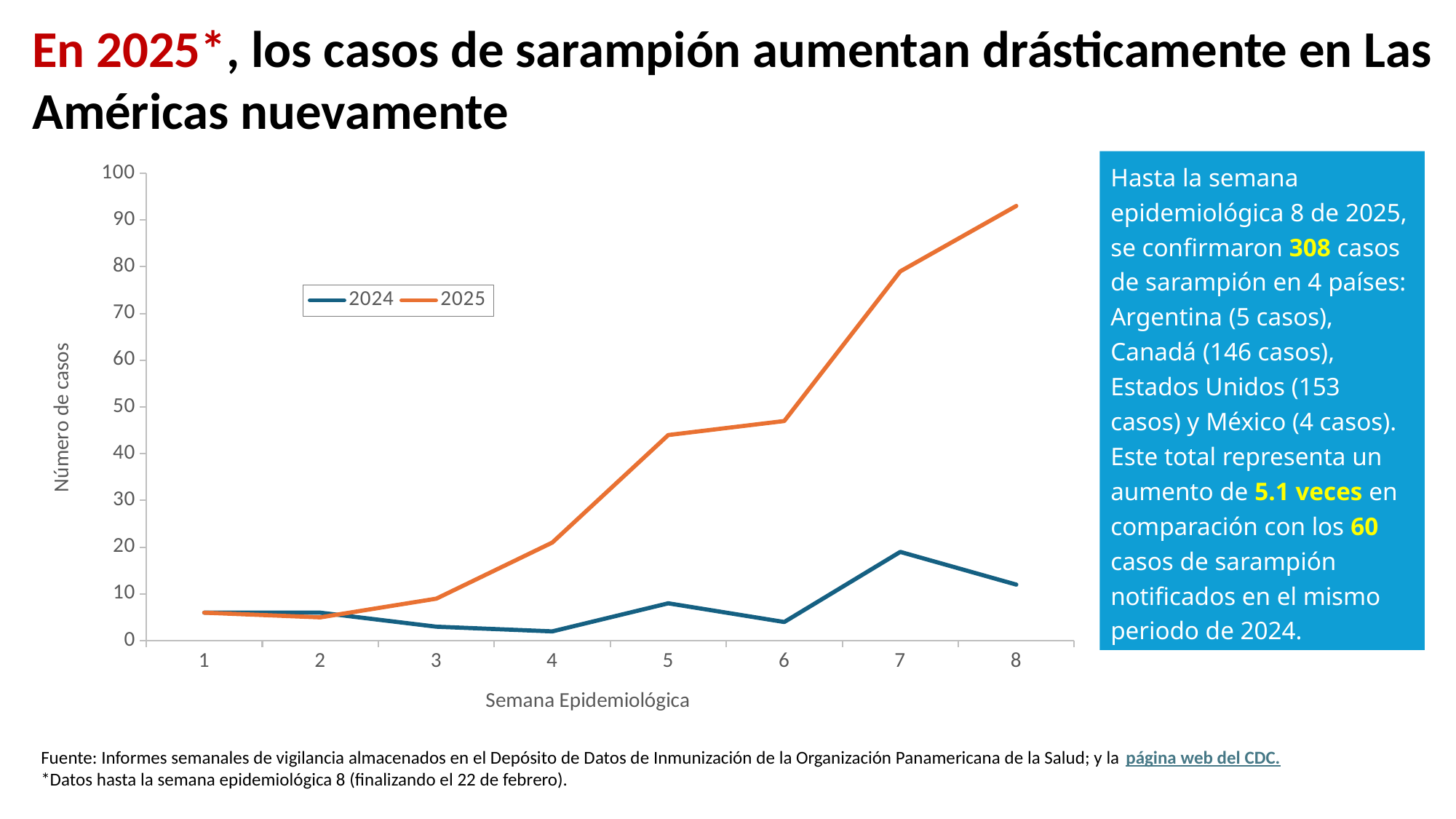
What kind of chart is shown on the slide? line chart How many series does the chart legend list? 2 Is the value for 2025 in week 7 greater or less than 70? greater What is the title of the y axis? Número de casos Is the value for 2025 in week 4 greater or less than 30? less In week 8, which series has the larger value, 2024 or 2025? 2025 How many epidemiological weeks are plotted along the x axis? 8 Is the value for 2024 in week 7 greater or less than 30? less In which epidemiological week does the 2024 series reach its highest value? 7 In which epidemiological week does the 2025 series reach its highest value? 8 Does the 2025 series generally rise or fall from week 3 to week 8? rise